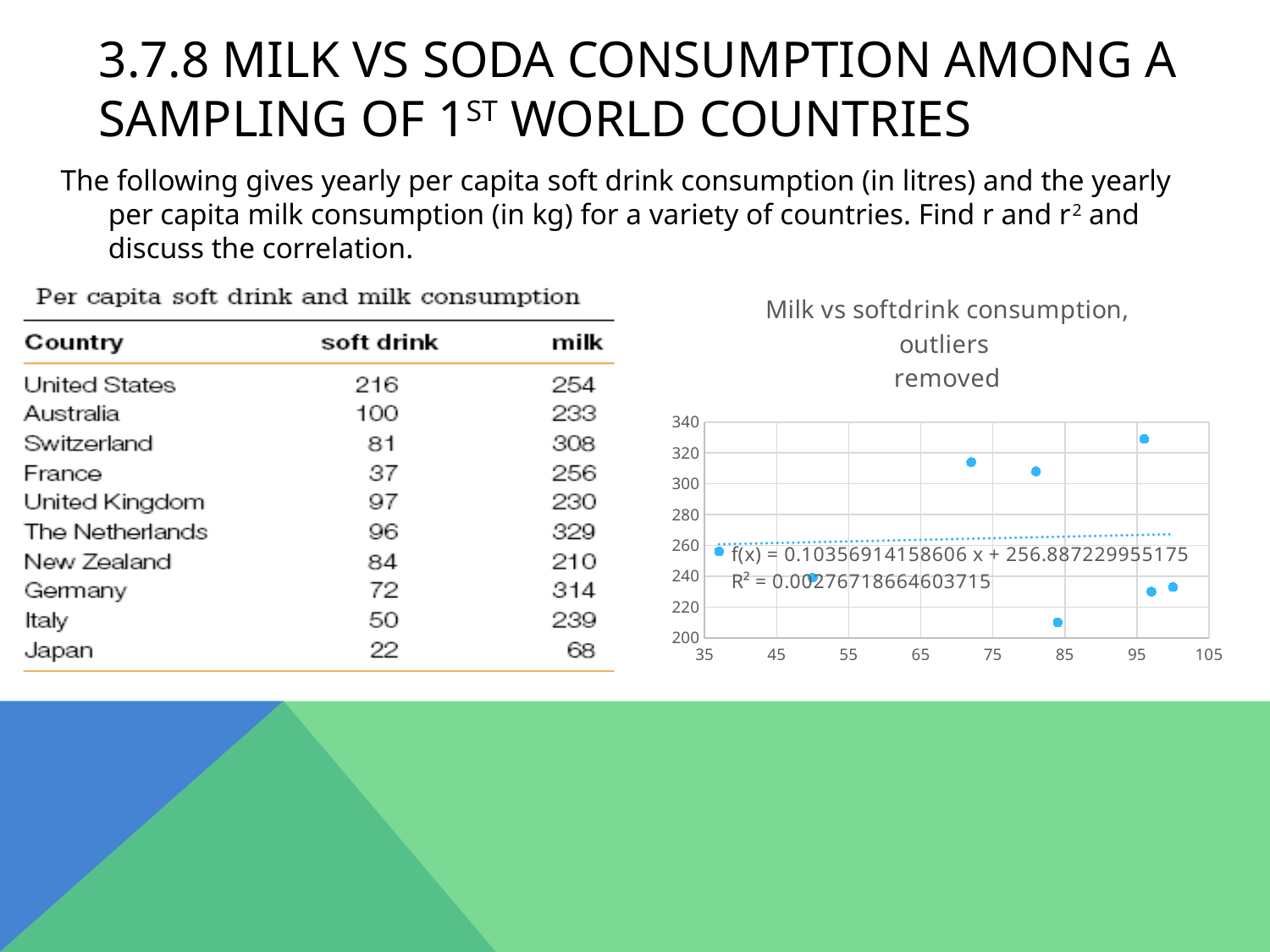
What is the title of the chart on the slide? Milk vs softdrink consumption, outliers removed Which point has the highest y-value: the one at x ≈ 72 or the one at x ≈ 96? the one at x ≈ 96 Is the y-value of the point at x ≈ 96 greater or less than 320? greater Is the y-value of the point at x ≈ 84 greater or less than 220? less What kind of chart is shown on the slide? scatter chart What is the trend line equation shown on the chart? f(x) = 0.10356914158606 x + 256.887229955175 What is the R² value shown on the chart? 0.00276718664603715 What is the lowest value shown on the y axis of the chart? 200 Does the trend line rise or fall along the x axis? rises slightly Is the y-value of the point at x ≈ 72 greater or less than 300? greater How many data points are plotted in the chart? 8